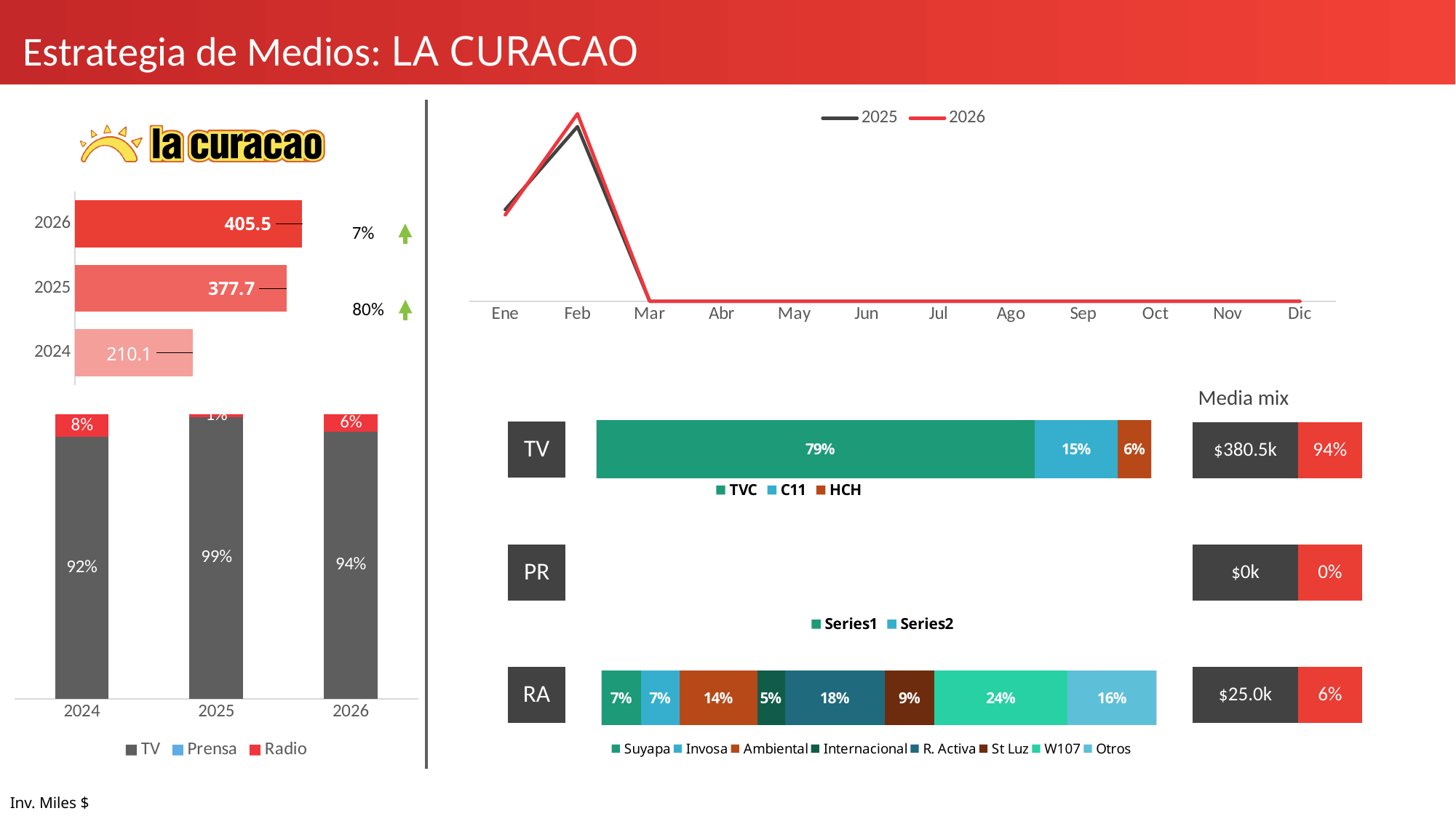
In the horizontal bar chart on the left showing yearly investment, what is the value for 2026? 405.5 In the horizontal bar chart on the left showing yearly investment, which year has the lowest value? 2024 In the line chart at the top right, in which month do both lines reach their peak? Feb In the TV stacked bar on the right, what is the share for C11? 15% In the stacked bar chart at the bottom left, what is the Radio share for 2024? 8% In the line chart at the top right, how many months are shown on the x axis? 12 In the Media mix column on the right, what is the dollar value shown for RA? $25.0k In the horizontal bar chart on the left showing yearly investment, do the values rise or fall from 2024 to 2026? rise In the stacked bar chart at the bottom left, how many series does the legend list? 3 In the stacked bar chart at the bottom left, what is the TV share for 2025? 99% In the RA stacked bar on the right, which station has the largest share? W107 In the horizontal bar chart on the left showing yearly investment, what is the difference between the 2026 and 2025 values? 27.8